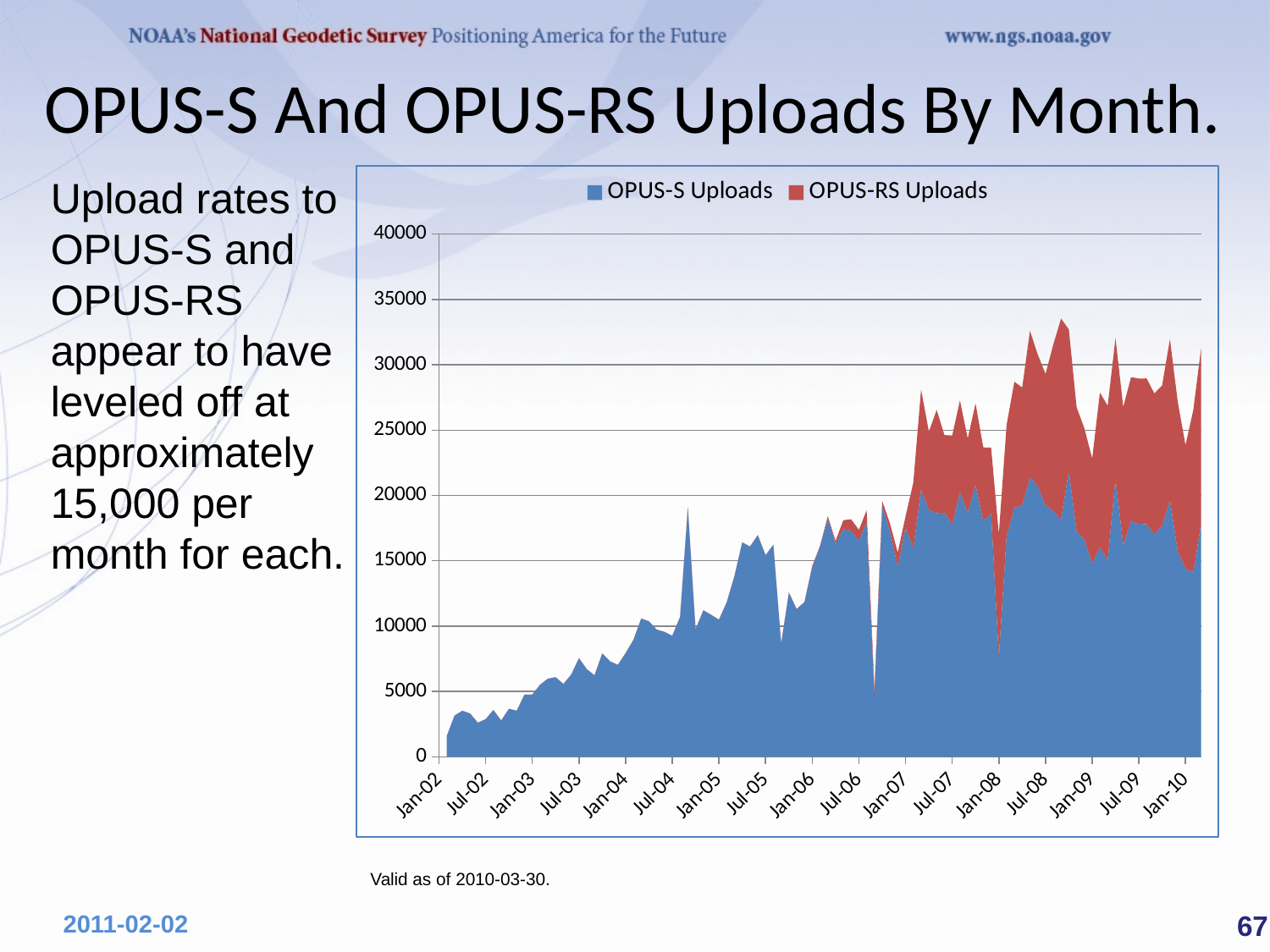
What is the last date label on the chart's x axis? Jan-10 What are the two series named in the chart legend? OPUS-S Uploads and OPUS-RS Uploads Is the value for OPUS-S Uploads at Jan-04 greater or less than 10000? less Is the total stacked value at Jan-10 greater or less than 25000? greater What kind of chart is shown on the slide? Stacked area chart Is the value for OPUS-S Uploads at Jan-02 greater or less than 5000? less How many series does the chart legend list? 2 Which colour represents OPUS-RS Uploads in the chart? Red What is the highest value shown on the chart's y axis? 40000 How many date labels are shown along the x axis of the chart? 17 What is the first date label on the chart's x axis? Jan-02 Overall, do OPUS-S Uploads rise or fall from Jan-02 to Jan-10? Rise